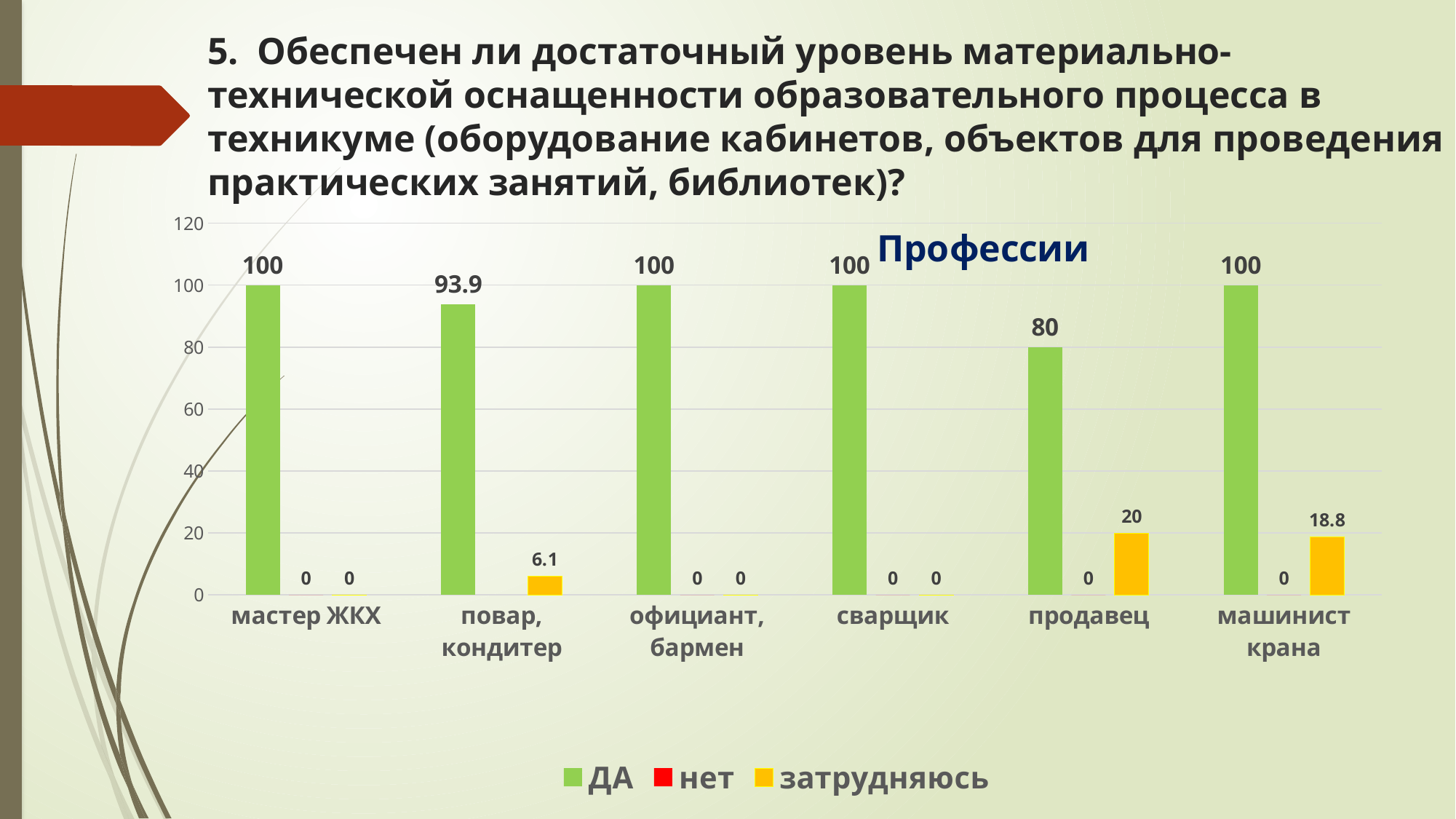
How many series does the legend list? 3 What is the value of ДА for повар, кондитер? 93.9 Which profession has the highest value for затрудняюсь? продавец What is the value of ДА for продавец? 80 What is the value of затрудняюсь for машинист крана? 18.8 Which profession has the lowest value for ДА? продавец Which is larger: the затрудняюсь value for продавец or for машинист крана? продавец What is the value of затрудняюсь for повар, кондитер? 6.1 What kind of chart is shown on the slide? bar chart How many profession categories are shown on the x axis? 6 What is the difference between the ДА values for мастер ЖКХ and продавец? 20 What is the title of the chart? Профессии